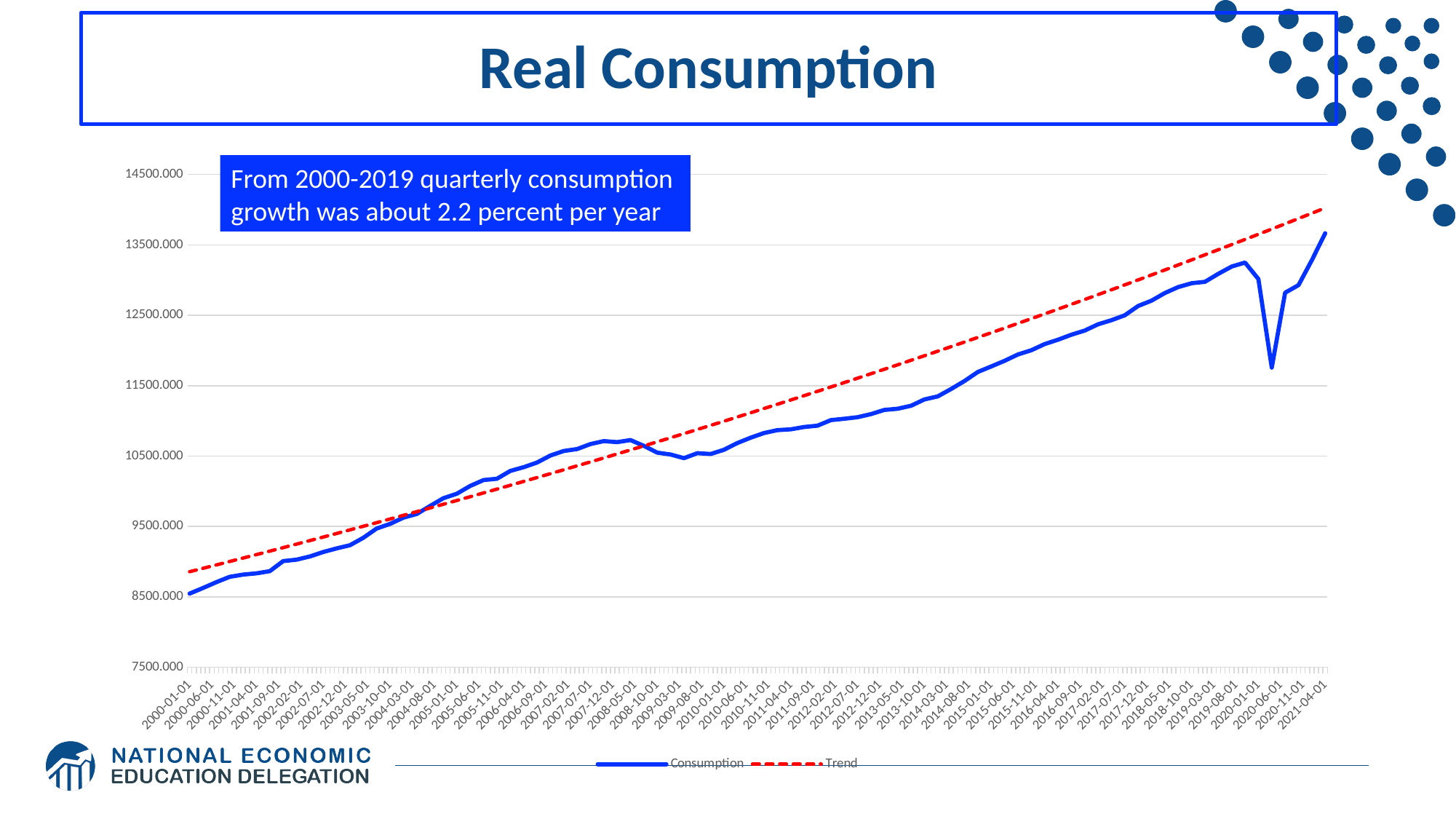
Is the Trend value at 2021-04-01 greater or less than 13500? greater At 2021-04-01, which series is higher, Consumption or Trend? Trend At 2000-01-01, which series is higher, Consumption or Trend? Trend What kind of chart is shown on the slide? line chart Is the Consumption value at 2021-04-01 greater or less than 12500? greater What are the two series named in the legend? Consumption and Trend Does the Consumption series generally rise or fall from 2000-01-01 to 2021-04-01? rise At which date does the Consumption series reach its lowest value? 2000-01-01 How many series does the legend list? 2 What is the title of the chart? Real Consumption Is the Consumption value at 2000-01-01 greater or less than 9500? less